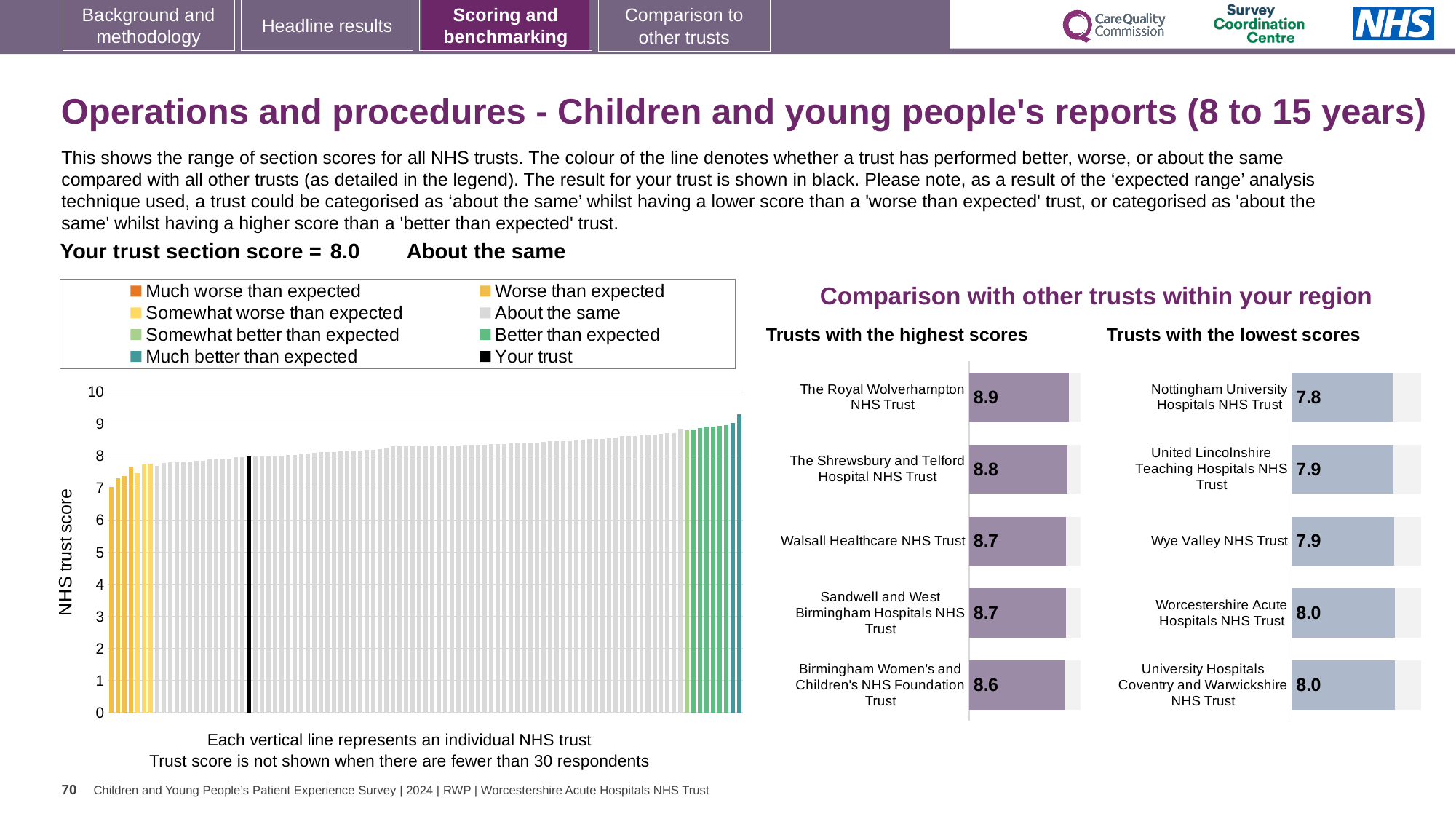
In the 'Trusts with the lowest scores' chart, which trust has the lowest score? Nottingham University Hospitals NHS Trust In the 'Trusts with the lowest scores' chart, what is the difference between the scores of Worcestershire Acute Hospitals NHS Trust and Nottingham University Hospitals NHS Trust? 0.2 In the 'Trusts with the highest scores' chart, which trust has the highest score? The Royal Wolverhampton NHS Trust In the 'Trusts with the highest scores' chart, which has the larger score: The Shrewsbury and Telford Hospital NHS Trust or Birmingham Women's and Children's NHS Foundation Trust? The Shrewsbury and Telford Hospital NHS Trust In the 'Trusts with the lowest scores' chart, what is the score for Nottingham University Hospitals NHS Trust? 7.8 How many entries does the legend of the main chart on the left list? 8 In the 'Trusts with the highest scores' chart, what is the difference between the scores of The Royal Wolverhampton NHS Trust and Birmingham Women's and Children's NHS Foundation Trust? 0.3 In the main chart on the left showing the range of section scores, what is the score for your trust (the black bar)? 8.0 How many trusts are shown in the 'Trusts with the lowest scores' chart? 5 In the main chart on the left, do the trust scores rise or fall from left to right? rise In the 'Trusts with the highest scores' chart, what is the score for The Royal Wolverhampton NHS Trust? 8.9 In the 'Trusts with the highest scores' chart, which trust has the lowest score? Birmingham Women's and Children's NHS Foundation Trust